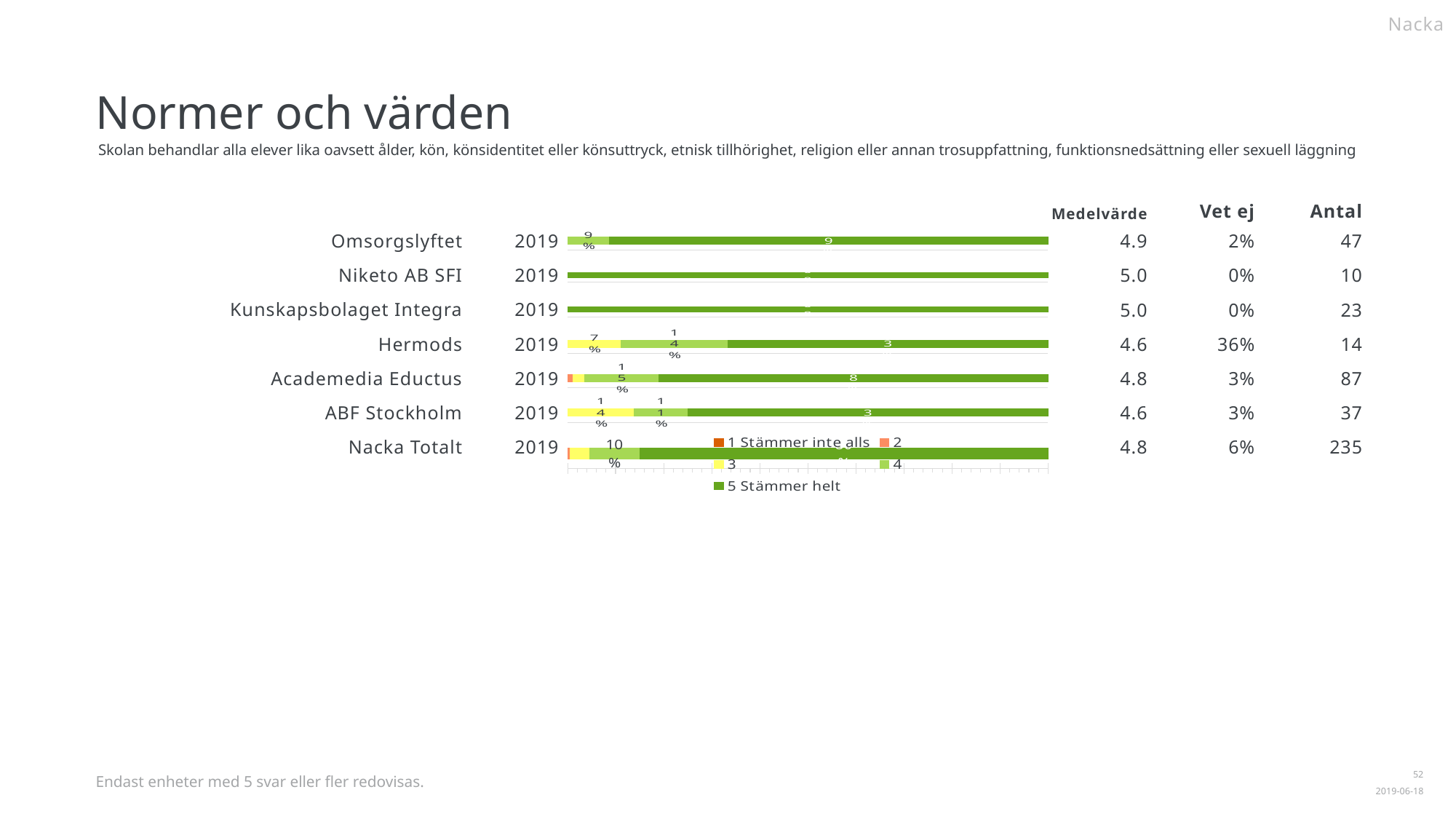
What Medelvärde is shown for Hermods? 4.6 How many series does the chart legend list? 5 What Antal is shown for Nacka Totalt? 235 Which has the larger '4' segment, Hermods or ABF Stockholm? Hermods What is the data label for the '3' segment of the Hermods bar? 7% What is the legend label for the dark green series? 5 Stämmer helt What is the data label for the '4' segment of the ABF Stockholm bar? 11% What kind of chart is shown on the slide? bar chart What is the data label for the '4' segment of the Academedia Eductus bar? 15% What is the difference between the '3' segment of ABF Stockholm (14%) and the '3' segment of Hermods (7%)? 7 percentage points How many categories (rows) are plotted in the chart? 7